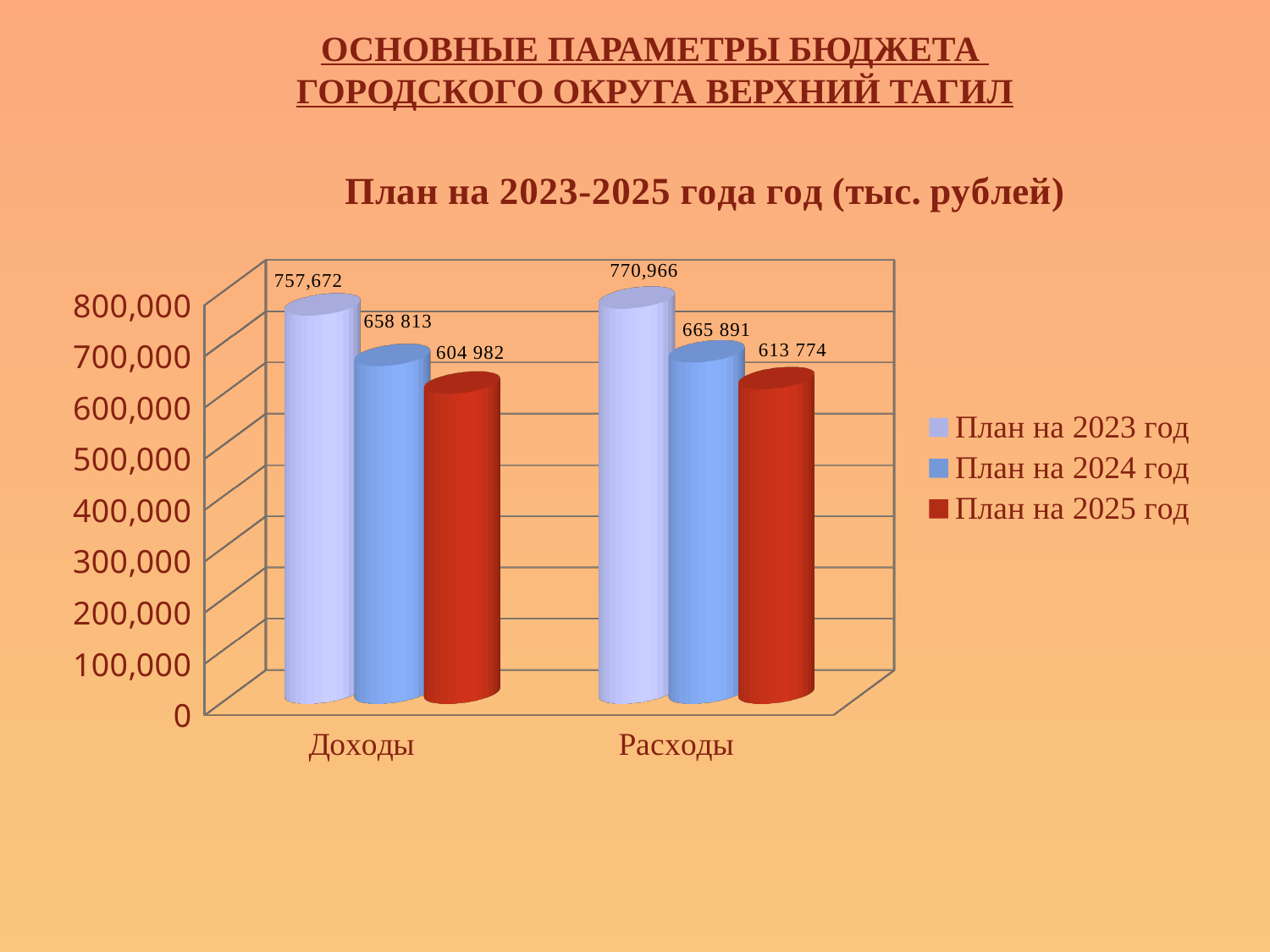
How many categories are shown on the x axis? 2 How many series does the legend list? 3 What is the value for Расходы in the series План на 2025 год? 613 774 Which is larger: Доходы or Расходы in the series План на 2025 год? Расходы What is the value for Расходы in the series План на 2023 год? 770,966 What is the value for Доходы in the series План на 2023 год? 757,672 What kind of chart is shown on the slide? Bar chart What is the value for Доходы in the series План на 2024 год? 658 813 Which series has the lowest value for Доходы? План на 2025 год What is the difference between Расходы and Доходы in the series План на 2023 год? 13,294 What is the difference between Расходы and Доходы in the series План на 2024 год? 7 078 Which series has the highest value for Расходы? План на 2023 год